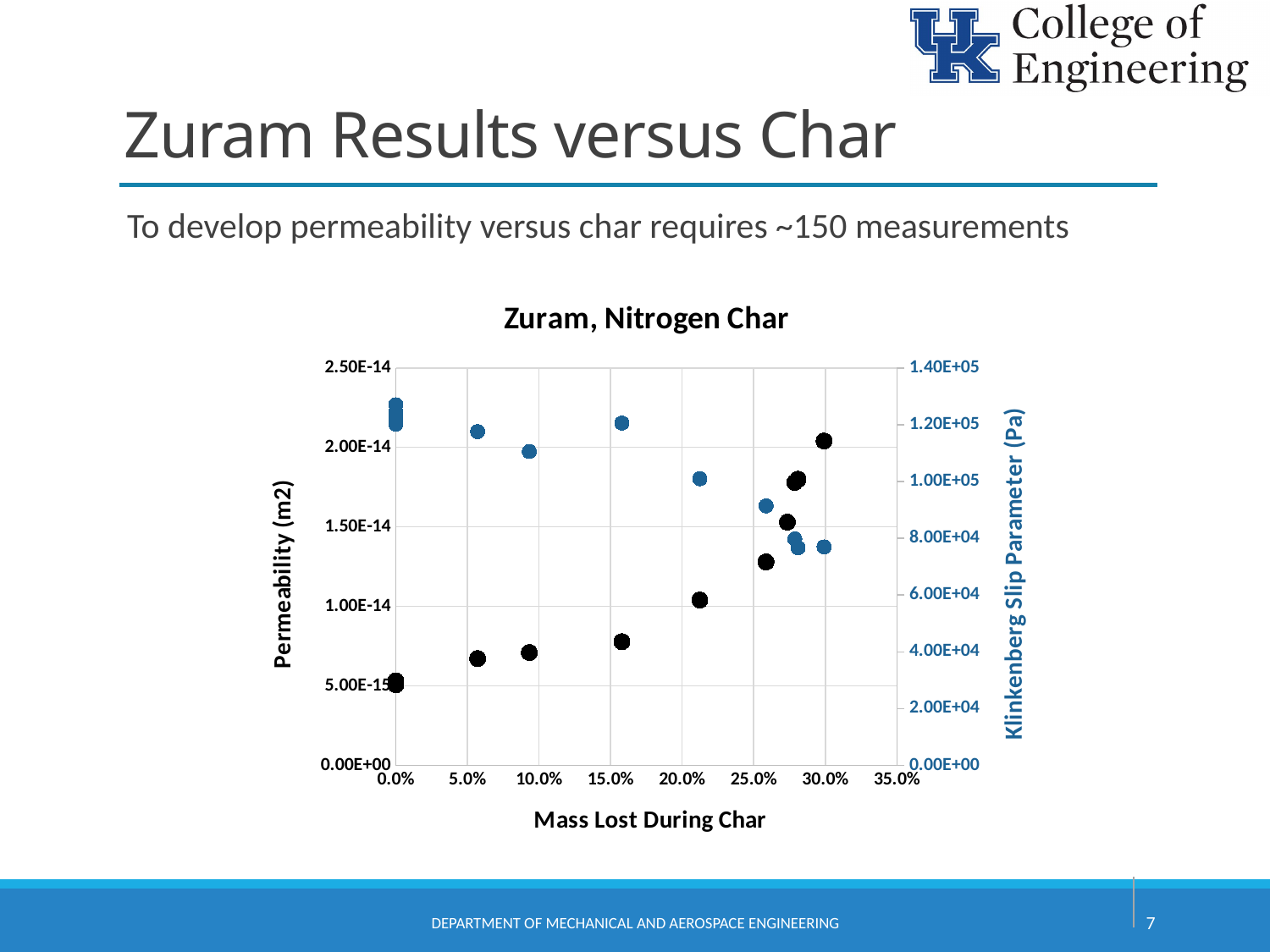
What type of chart is shown on the slide? scatter chart Which has the higher Klinkenberg slip parameter: the blue point near 0.0% mass lost or the blue point near 30.0% mass lost? the point near 0.0% Is the permeability value for the black point near 21.0% mass lost greater or less than 1.50E-14? less Is the permeability value for the black point near 5.0% mass lost greater or less than 1.00E-14? less What is the title of the chart? Zuram, Nitrogen Char Is the permeability value for the black point near 30.0% mass lost greater or less than 1.50E-14? greater Do the black permeability points generally rise or fall as mass lost during char increases? rise Do the blue Klinkenberg slip parameter points generally rise or fall as mass lost during char increases? fall What is the label of the x axis of the chart? Mass Lost During Char Which has the higher permeability: the black point near 30.0% mass lost or the black point near 5.0% mass lost? the point near 30.0%